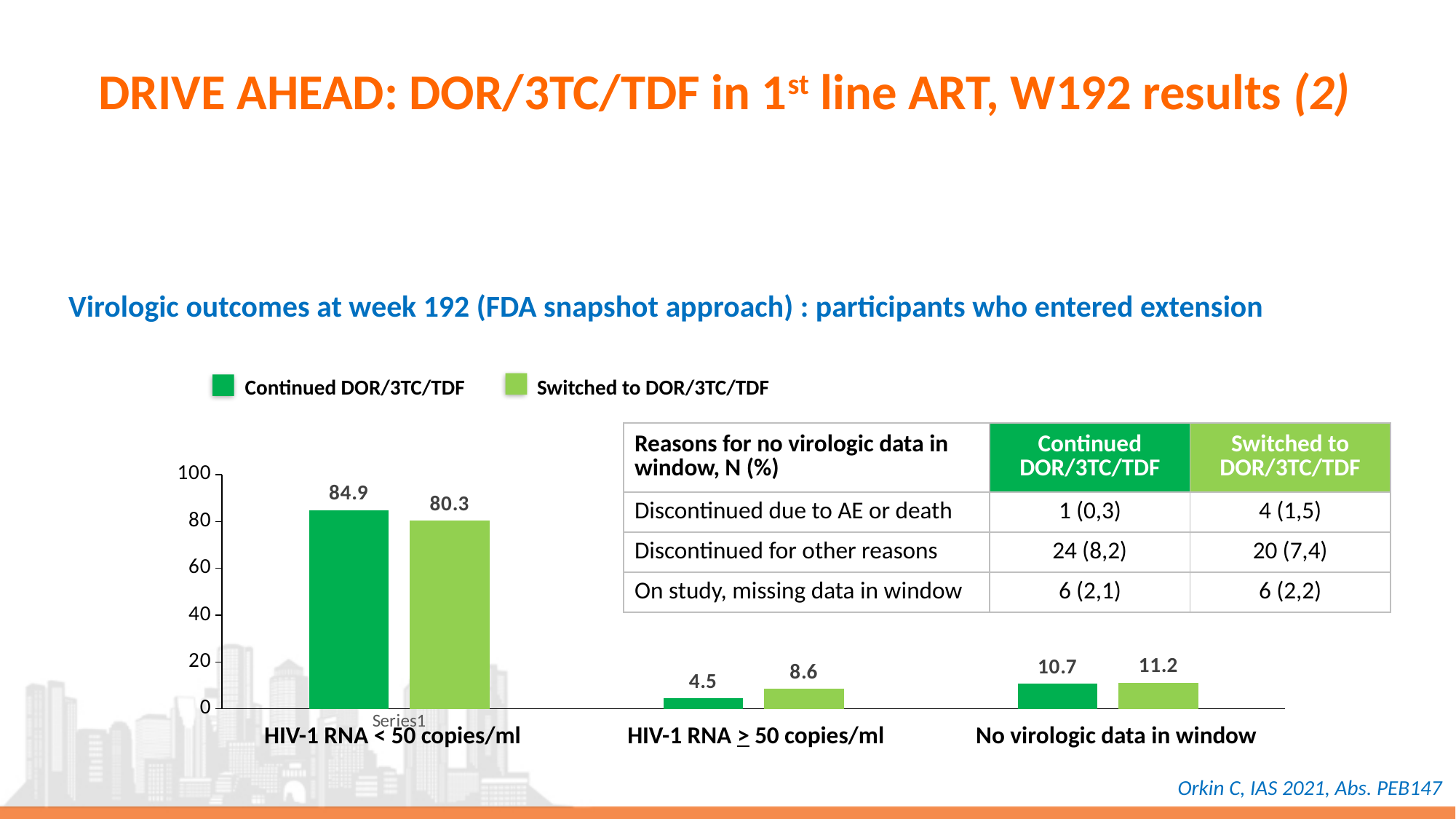
What is the value for Continued DOR/3TC/TDF in the No virologic data in window category? 10.7 What is the difference between the Continued DOR/3TC/TDF and Switched to DOR/3TC/TDF values in the HIV-1 RNA < 50 copies/ml category? 4.6 How many series does the chart legend list? 2 In the HIV-1 RNA ≥ 50 copies/ml category, which series has the larger value, Continued DOR/3TC/TDF or Switched to DOR/3TC/TDF? Switched to DOR/3TC/TDF How many categories are shown on the x axis of the chart? 3 What kind of chart is shown on the slide? Bar chart What is the value for Switched to DOR/3TC/TDF in the HIV-1 RNA < 50 copies/ml category? 80.3 What is the value for Switched to DOR/3TC/TDF in the HIV-1 RNA ≥ 50 copies/ml category? 8.6 Which category has the lowest value for Switched to DOR/3TC/TDF? HIV-1 RNA ≥ 50 copies/ml What is the value for Continued DOR/3TC/TDF in the HIV-1 RNA < 50 copies/ml category? 84.9 Which category has the highest value for Continued DOR/3TC/TDF? HIV-1 RNA < 50 copies/ml Is the value for Continued DOR/3TC/TDF in the HIV-1 RNA < 50 copies/ml category greater or less than 80? greater